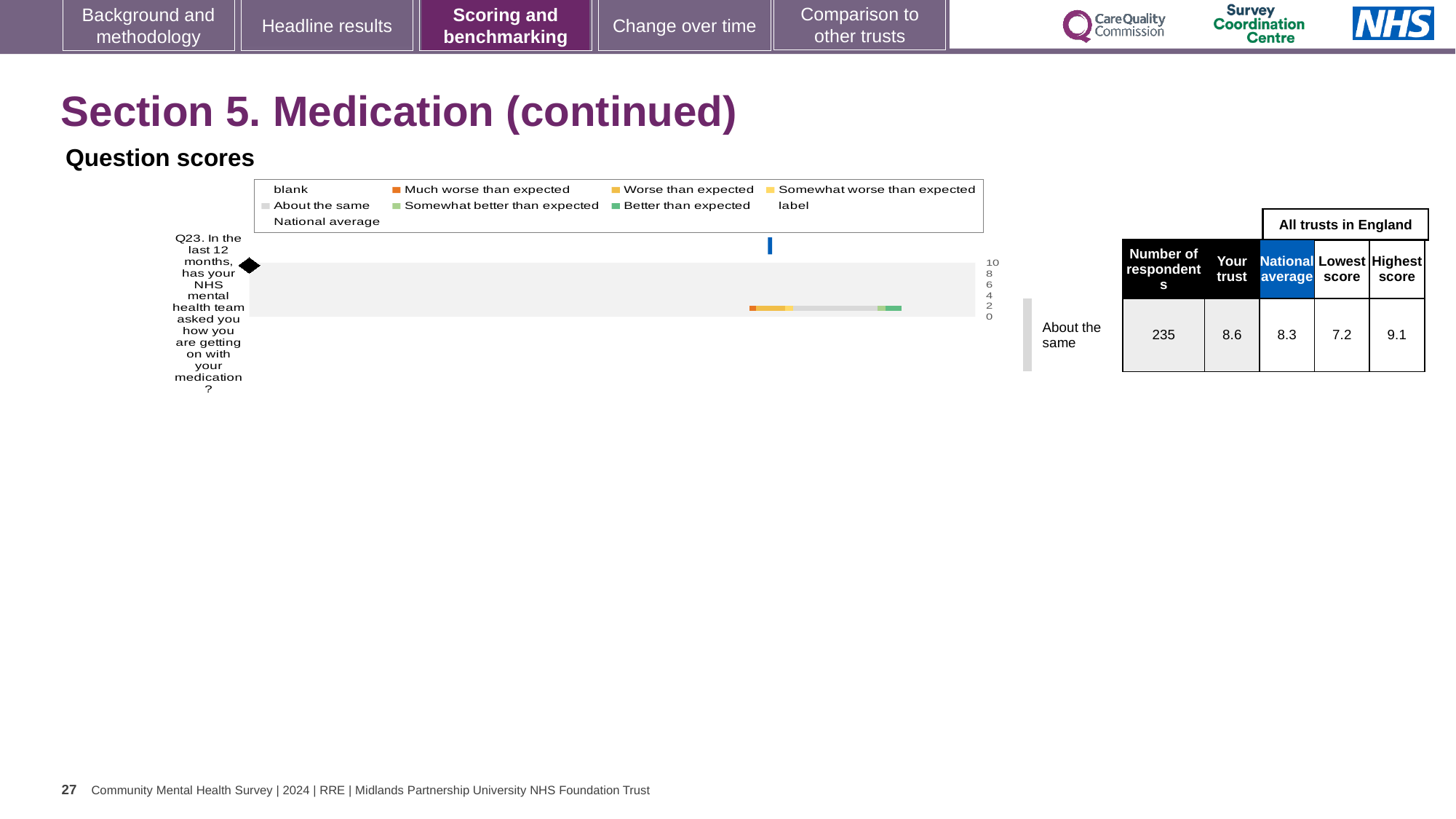
How many respondents answered Q23? 235 How many survey questions are plotted on the chart? 1 What is the national average score for Q23? 8.3 By how much does the 'Your trust' score for Q23 exceed the national average? 0.3 Which question is plotted on the chart? Q23. In the last 12 months, has your NHS mental health team asked you how you are getting on with your medication? What is the highest score among all trusts in England for Q23? 9.1 What is the 'Your trust' score for Q23? 8.6 What is the lowest score among all trusts in England for Q23? 7.2 What kind of chart is used to show the Q23 question score? bar chart What is the difference between the highest and lowest scores for Q23 across all trusts in England? 1.9 What benchmark category is the trust's Q23 score placed in? About the same Which is larger for Q23, the 'Your trust' score or the national average? Your trust